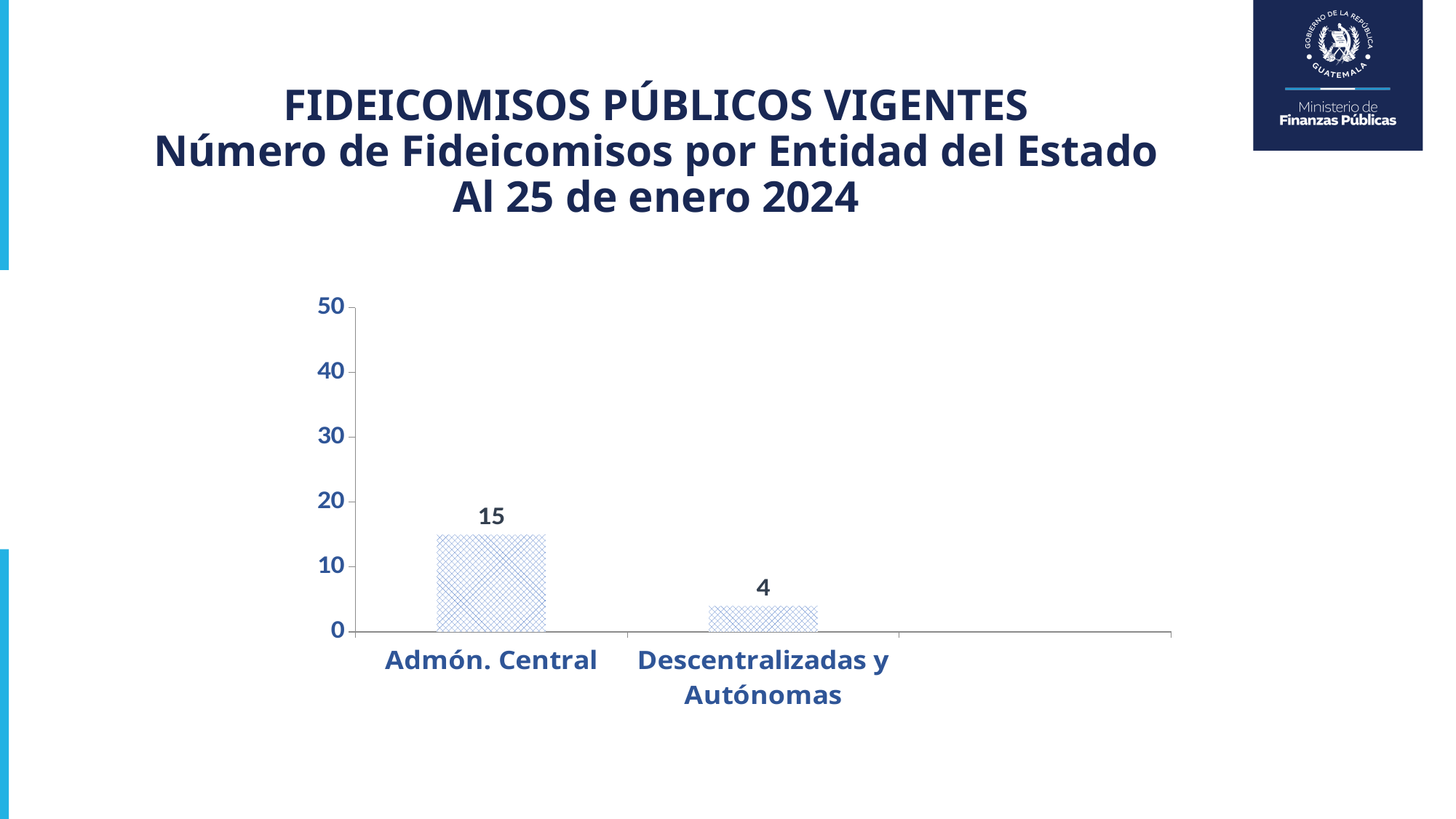
What is the difference between the values for Admón. Central and Descentralizadas y Autónomas? 11 Which is larger, the value for Admón. Central or the value for Descentralizadas y Autónomas? Admón. Central What kind of chart is shown on the slide? Bar chart What is the value for Descentralizadas y Autónomas? 4 How many categories are shown on the chart? 2 Is the value for Descentralizadas y Autónomas greater or less than 10? less Which category has the highest value? Admón. Central What is the value for Admón. Central? 15 What is the total of the two values shown on the chart? 19 What is the highest value shown on the vertical axis? 50 Which category has the lowest value? Descentralizadas y Autónomas Is the value for Admón. Central greater or less than 20? less